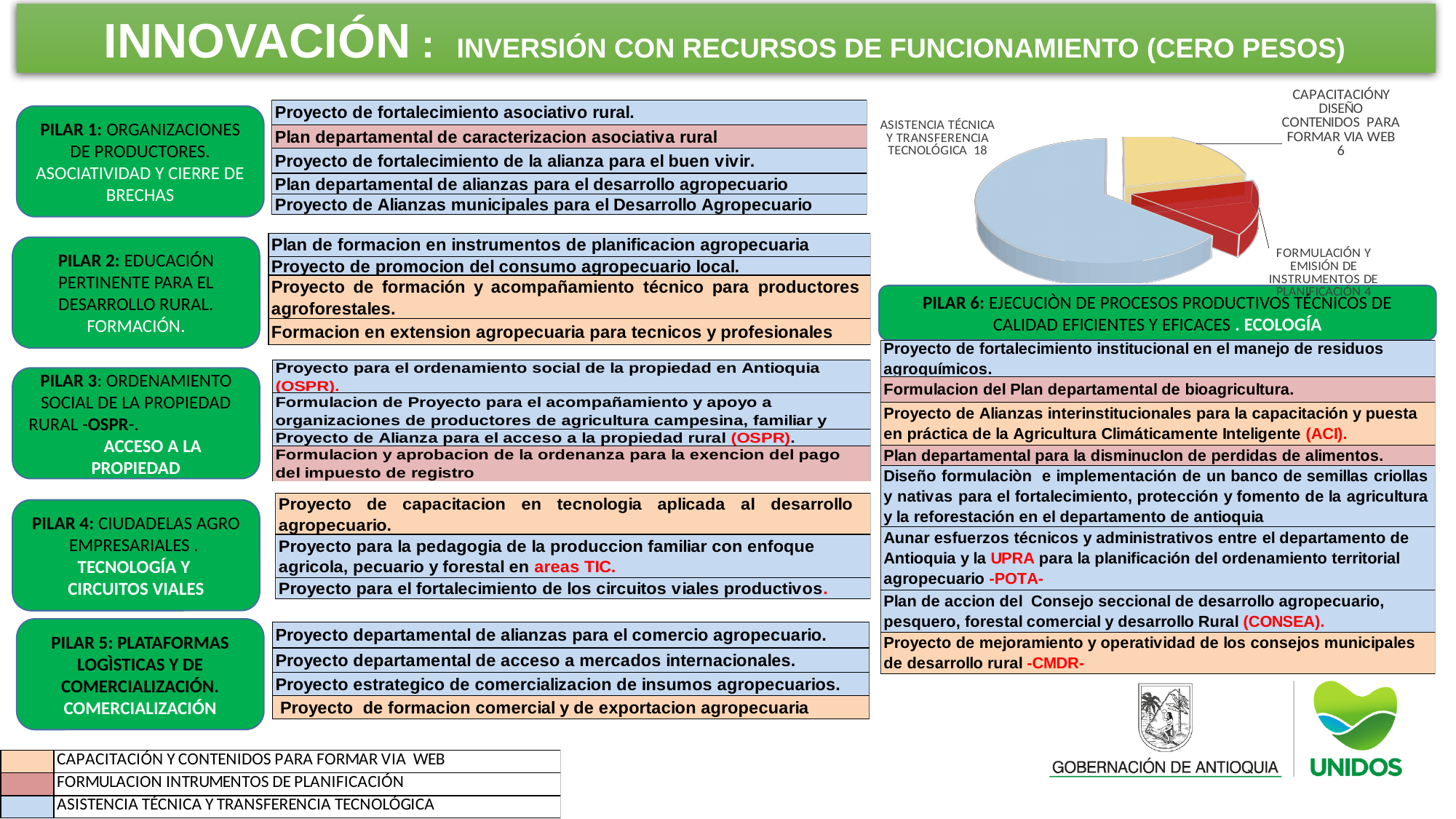
What is the difference between the values for ASISTENCIA TÉCNICA Y TRANSFERENCIA TECNOLÓGICA and CAPACITACIÓN Y DISEÑO CONTENIDOS PARA FORMAR VIA WEB? 12 Which category has the largest slice in the pie chart? ASISTENCIA TÉCNICA Y TRANSFERENCIA TECNOLÓGICA How many slices does the pie chart have? 3 What is the value for ASISTENCIA TÉCNICA Y TRANSFERENCIA TECNOLÓGICA in the pie chart? 18 What is the total of all slices in the pie chart? 28 What colour is the slice for FORMULACIÓN Y EMISIÓN DE INSTRUMENTOS DE PLANIFICACIÓN in the pie chart? red Which category has the smallest slice in the pie chart? FORMULACIÓN Y EMISIÓN DE INSTRUMENTOS DE PLANIFICACIÓN What is the value for CAPACITACIÓN Y DISEÑO CONTENIDOS PARA FORMAR VIA WEB in the pie chart? 6 What is the value for FORMULACIÓN Y EMISIÓN DE INSTRUMENTOS DE PLANIFICACIÓN in the pie chart? 4 Which is larger in the pie chart: CAPACITACIÓN Y DISEÑO CONTENIDOS PARA FORMAR VIA WEB or FORMULACIÓN Y EMISIÓN DE INSTRUMENTOS DE PLANIFICACIÓN? CAPACITACIÓN Y DISEÑO CONTENIDOS PARA FORMAR VIA WEB What type of chart is shown on the slide? pie chart